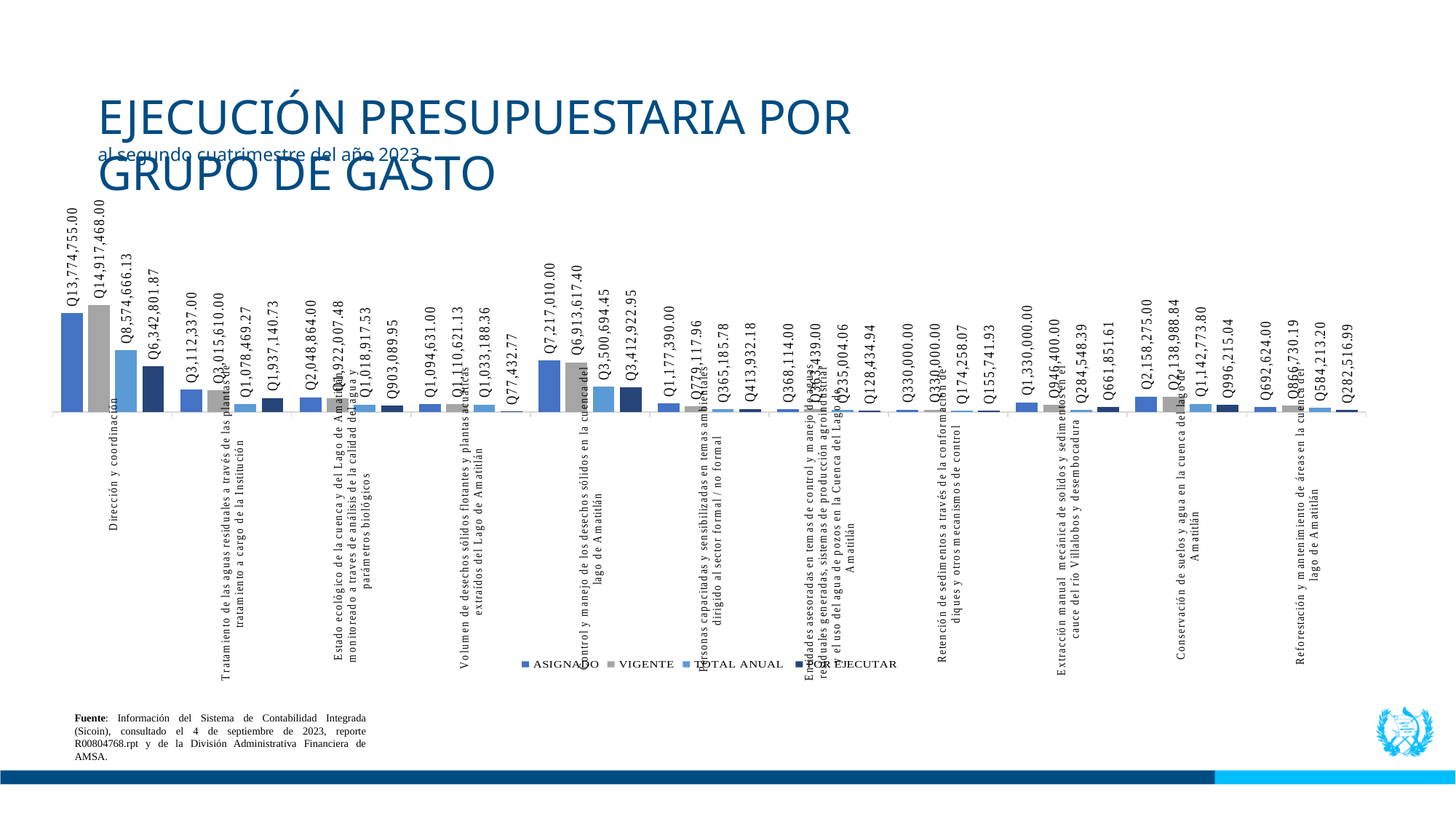
What is the POR EJECUTAR value for Volumen de desechos sólidos flotantes y plantas acuáticas extraídos del Lago de Amatitlán? Q77,432.77 How many series does the legend list? 4 What is the ASIGNADO value for Retención de sedimentos a través de la conformación de diques y otros mecanismos de control? Q330,000.00 What is the TOTAL ANUAL value for Control y manejo de los desechos sólidos en la cuenca del lago de Amatitlán? Q3,500,694.45 How many categories are shown on the x axis of the chart? 11 Which category has the highest VIGENTE value? Dirección y coordinación What is the difference between TOTAL ANUAL and POR EJECUTAR for Control y manejo de los desechos sólidos en la cuenca del lago de Amatitlán? Q87,771.50 For Tratamiento de las aguas residuales, which is larger: ASIGNADO or VIGENTE? ASIGNADO By how much does the VIGENTE value exceed the ASIGNADO value for Dirección y coordinación? Q1,142,713.00 What is the VIGENTE value for Dirección y coordinación? Q14,917,468.00 Which category has the lowest POR EJECUTAR value? Volumen de desechos sólidos flotantes y plantas acuáticas extraídos del Lago de Amatitlán What is the ASIGNADO value for Dirección y coordinación? Q13,774,755.00